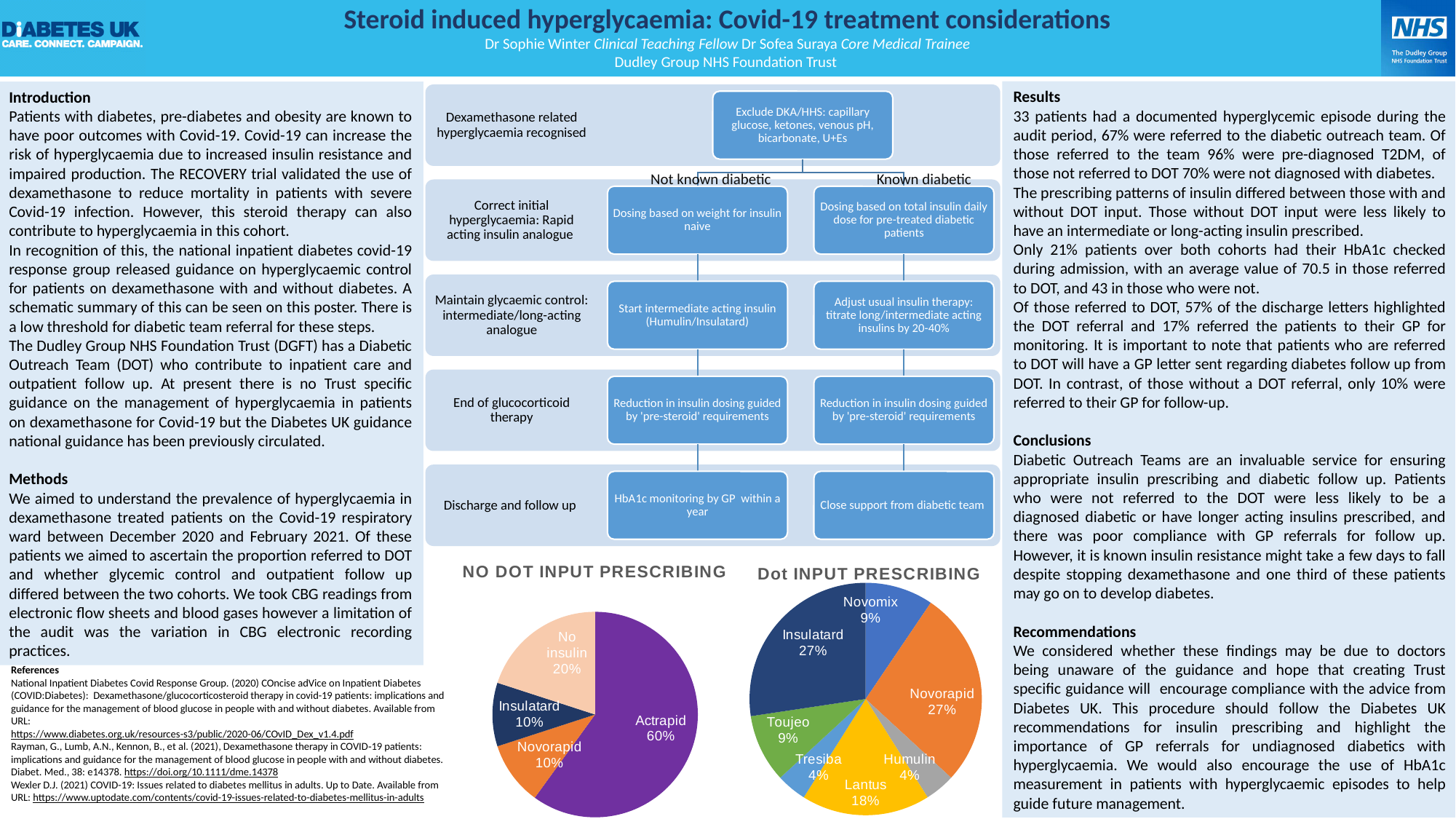
In the 'NO DOT INPUT PRESCRIBING' chart, what share of the pie is 'No insulin'? 20% In the 'NO DOT INPUT PRESCRIBING' chart, which category has the largest slice? Actrapid What type of chart is 'NO DOT INPUT PRESCRIBING'? Pie chart In the 'Dot INPUT PRESCRIBING' chart, which category has the smallest share, Lantus or Humulin? Humulin In the 'Dot INPUT PRESCRIBING' chart, what is the difference between the Novorapid share and the Novomix share? 18% In the 'NO DOT INPUT PRESCRIBING' chart, how many slices does the pie have? 4 In the 'NO DOT INPUT PRESCRIBING' chart, what is the difference between the Actrapid share and the 'No insulin' share? 40% In the 'NO DOT INPUT PRESCRIBING' chart, what share of the pie is Actrapid? 60% In the 'Dot INPUT PRESCRIBING' chart, what share of the pie is Toujeo? 9% In the 'Dot INPUT PRESCRIBING' chart, how many slices does the pie have? 7 What is the title of the chart on the right of the slide? Dot INPUT PRESCRIBING In the 'Dot INPUT PRESCRIBING' chart, what share of the pie is Lantus? 18%